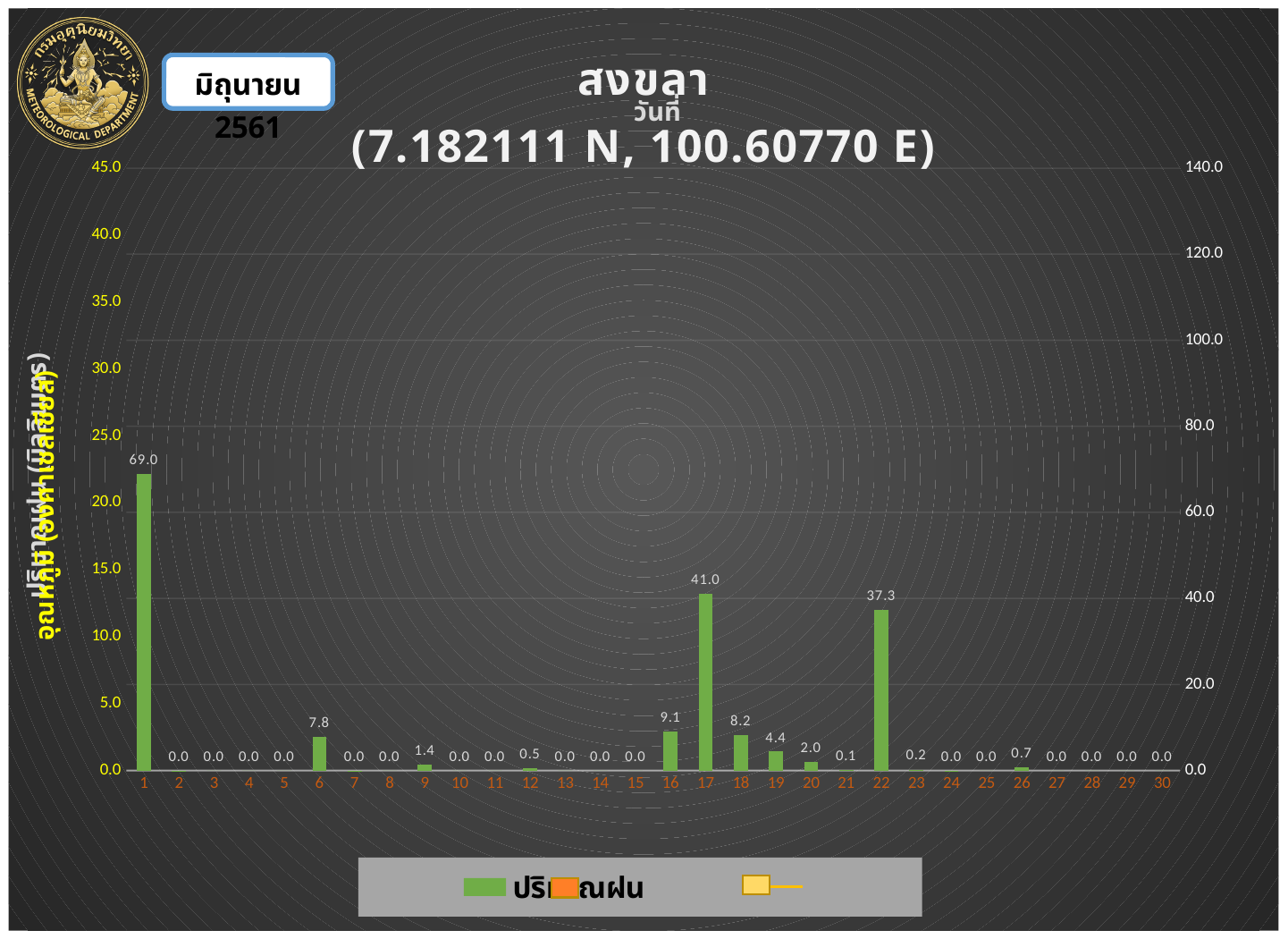
What is the rainfall value shown for day 17? 41.0 What kind of chart is shown on the slide? bar chart Which day has the larger rainfall value, day 17 or day 22? 17 What is the rainfall value shown for day 1? 69.0 How many days are shown on the x axis? 30 What is the rainfall value shown for day 16? 9.1 What is the rainfall value shown for day 22? 37.3 What is the difference between the rainfall values for day 1 and day 17? 28.0 What coordinates are given in the chart title? 7.182111 N, 100.60770 E What is the rainfall value shown for day 6? 7.8 Which day has the highest rainfall value? 1 What is the difference between the rainfall values for day 17 and day 22? 3.7